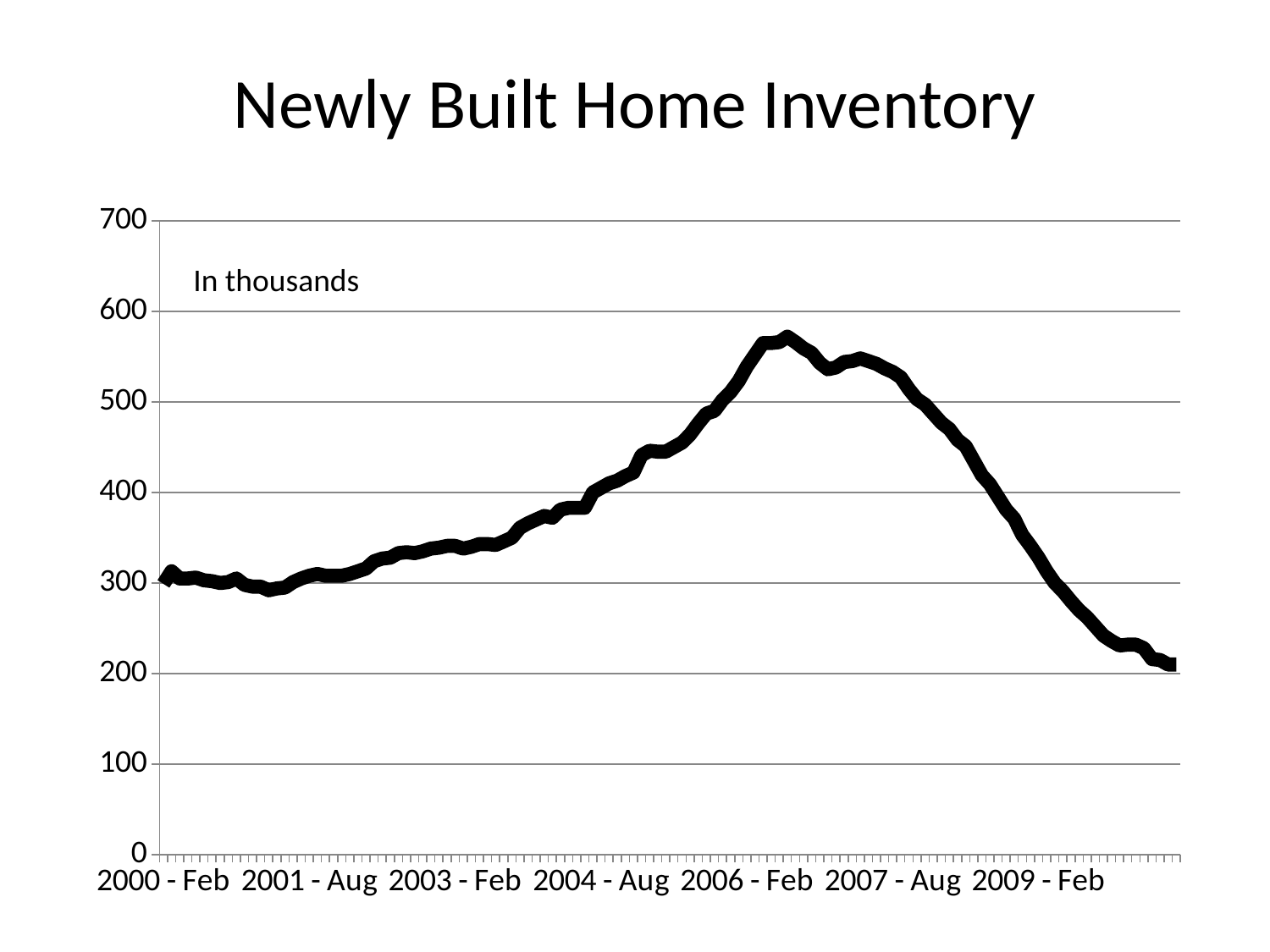
Is the value for 2001 - Aug greater or less than 400? less What unit does the annotation on the chart say the values are in? In thousands Does the line rise or fall between 2007 - Aug and the end of the series? Falls Is the value for 2006 - Feb greater or less than 500? greater What kind of chart is shown on the slide? Line chart Is the value for 2007 - Aug greater or less than 400? greater Which is larger, the value for 2006 - Feb or the value for 2009 - Feb? 2006 - Feb What is the title of the chart? Newly Built Home Inventory